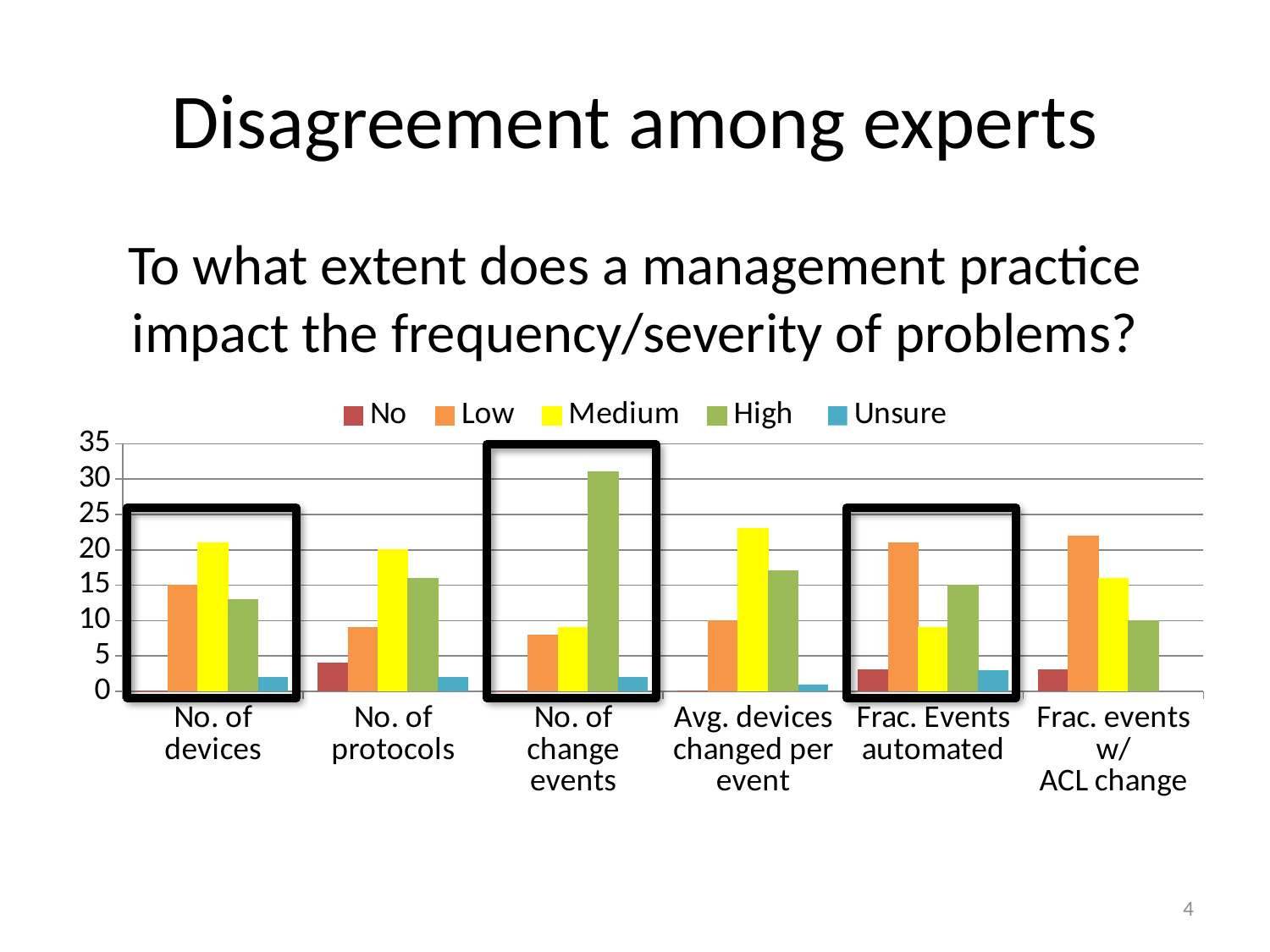
Which series has the tallest bar for 'Avg. devices changed per event'? Medium Which series has the tallest bar for 'No. of change events'? High What kind of chart is shown on the slide? bar chart What is the last entry listed in the legend? Unsure How many categories are shown along the x axis? 6 Which series has the tallest bar for 'Frac. events w/ ACL change'? Low Is the 'Medium' value for 'No. of devices' greater or less than 20? greater Is the 'High' value for 'No. of change events' greater or less than 30? greater For 'No. of protocols', which is larger, the 'Medium' bar or the 'High' bar? Medium How many series does the legend list? 5 Is the 'Low' value for 'No. of protocols' greater or less than 10? less For 'Frac. Events automated', which is larger, the 'Low' bar or the 'High' bar? Low